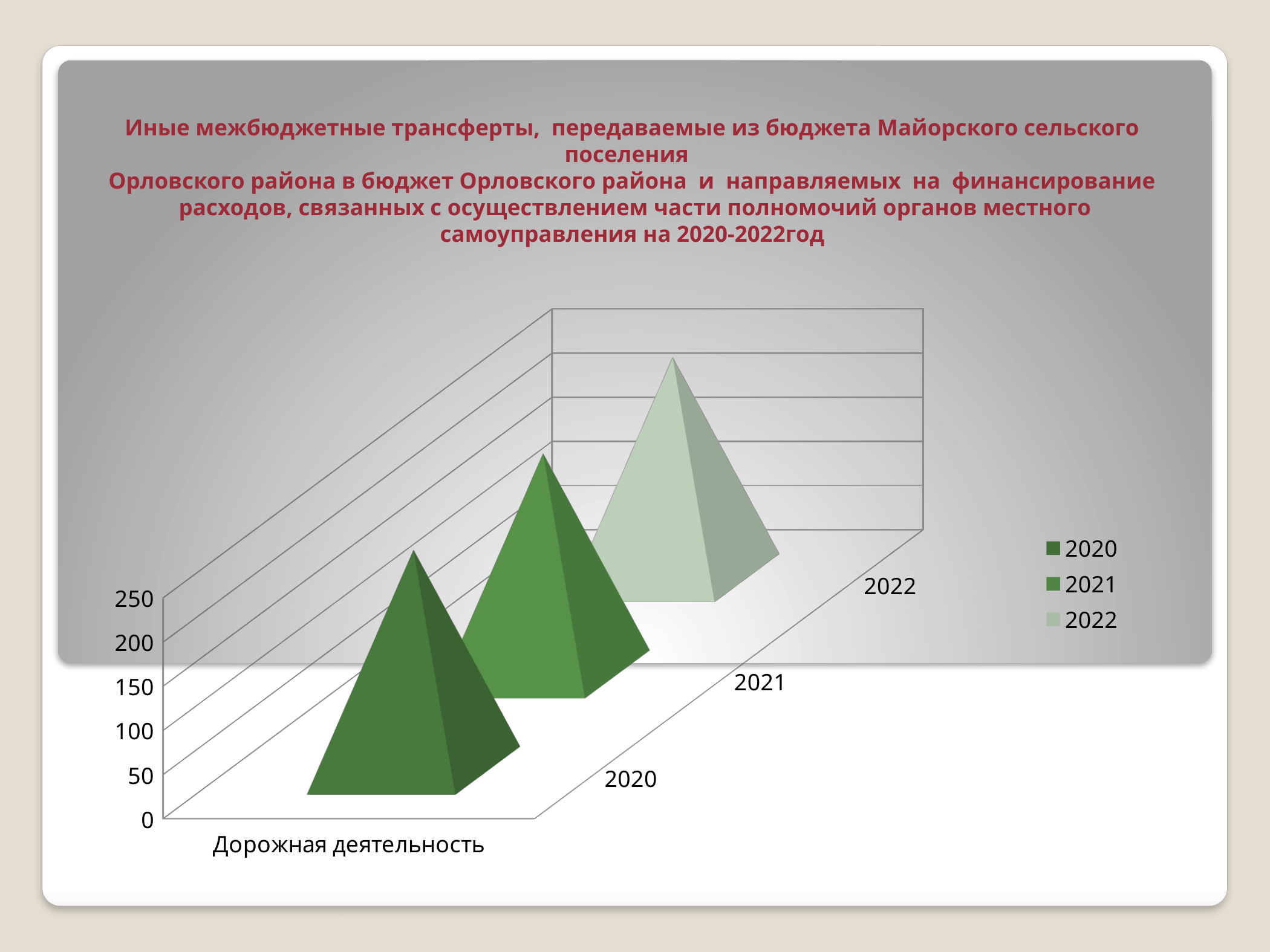
What is the name of the category shown on the x axis? Дорожная деятельность How many categories are shown on the x axis? 1 What is the highest value shown on the vertical axis? 250 Which series are listed in the legend? 2020, 2021, 2022 What kind of chart is shown on the slide? bar chart Is the value for 2020 in the category Дорожная деятельность greater or less than 150? greater Is the value for 2020 in the category Дорожная деятельность greater or less than 50? greater Is the value for 2022 in the category Дорожная деятельность greater or less than 100? greater How many series does the legend list? 3